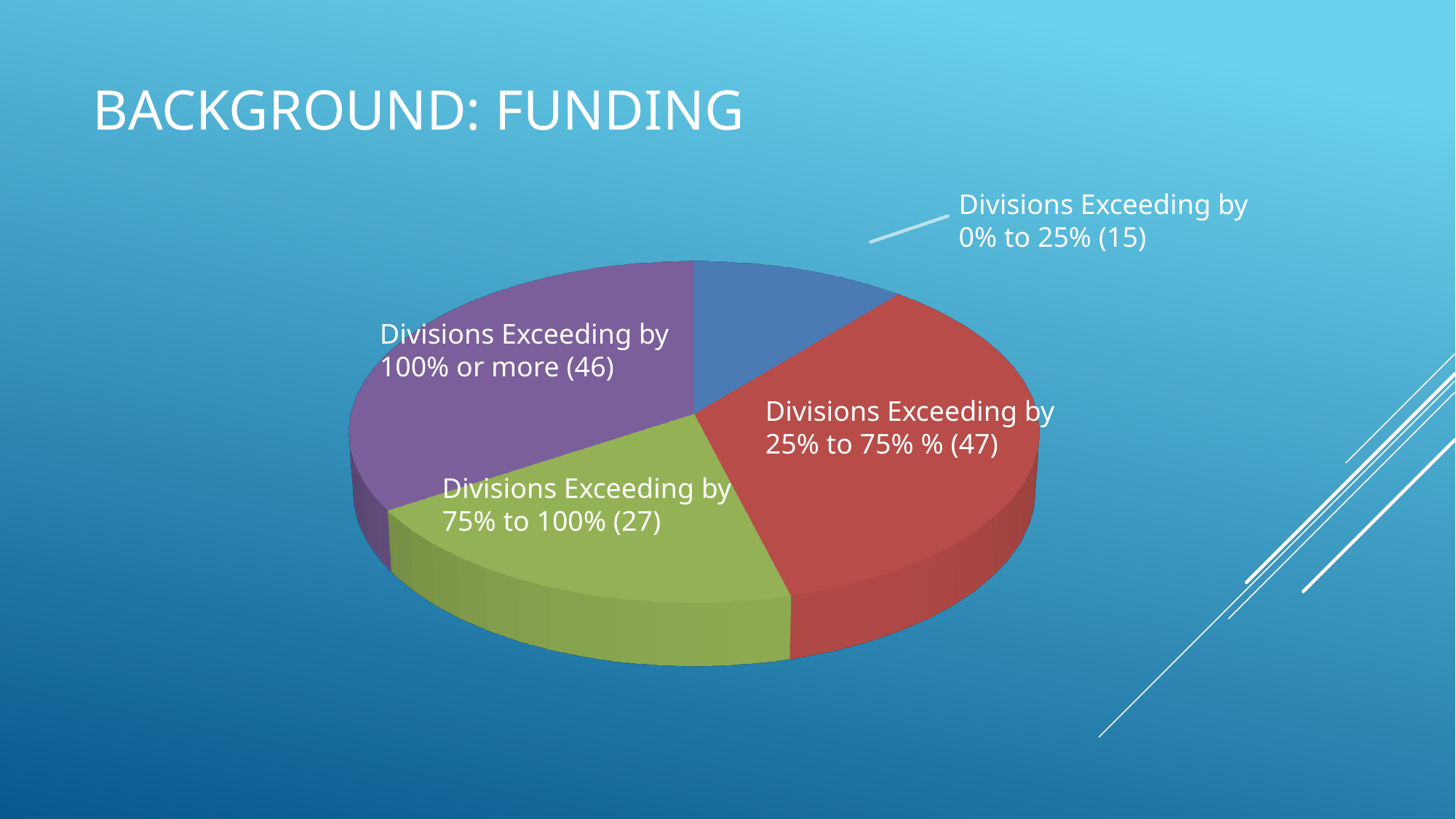
What is the value for Divisions Exceeding by 0% to 25%? 15 Which category has the largest slice? Divisions Exceeding by 25% to 75% What is the value for Divisions Exceeding by 75% to 100%? 27 What is the value for Divisions Exceeding by 100% or more? 46 What is the value for Divisions Exceeding by 25% to 75%? 47 What is the difference between the values for Divisions Exceeding by 25% to 75% and Divisions Exceeding by 0% to 25%? 32 Which category has the smallest slice? Divisions Exceeding by 0% to 25% How many slices does the pie chart have? 4 What type of chart is shown on the slide? Pie chart Which is larger: Divisions Exceeding by 100% or more, or Divisions Exceeding by 75% to 100%? Divisions Exceeding by 100% or more What is the title of the slide? BACKGROUND: FUNDING What is the total of all four slice values? 135